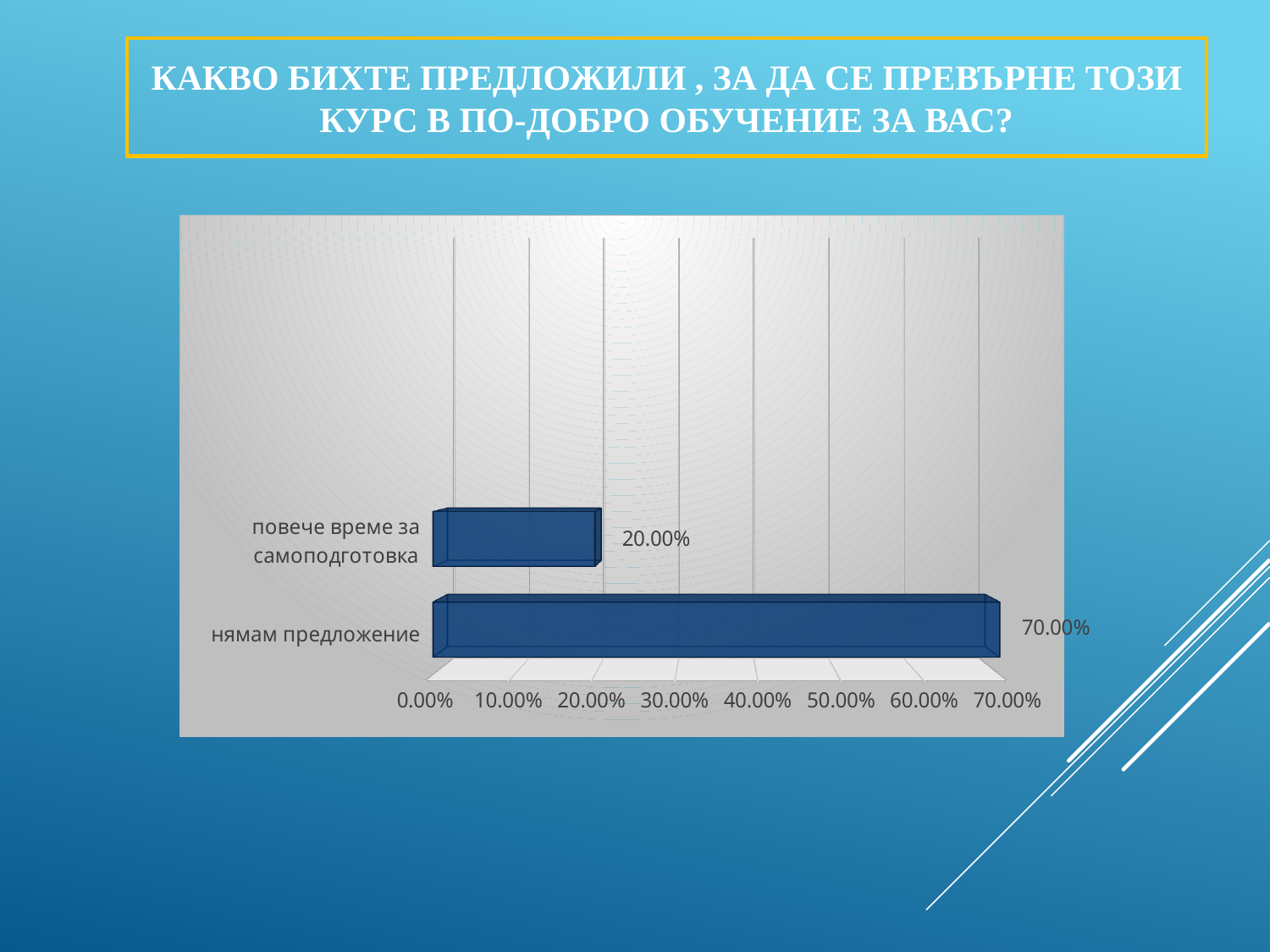
What kind of chart is shown on the slide? bar chart What is the difference between the values for "нямам предложение" and "повече време за самоподготовка"? 50.00% Are the bars in the chart horizontal or vertical? horizontal Is the value for "повече време за самоподготовка" greater or less than 30.00%? less How many categories are shown in the chart? 2 Which category has the lowest value? повече време за самоподготовка Which is larger: the value for "нямам предложение" or for "повече време за самоподготовка"? нямам предложение What is the value for "нямам предложение"? 70.00% Which category has the highest value? нямам предложение Is the value for "нямам предложение" greater or less than 50.00%? greater What is the value for "повече време за самоподготовка"? 20.00% What is the highest value shown on the horizontal axis? 70.00%